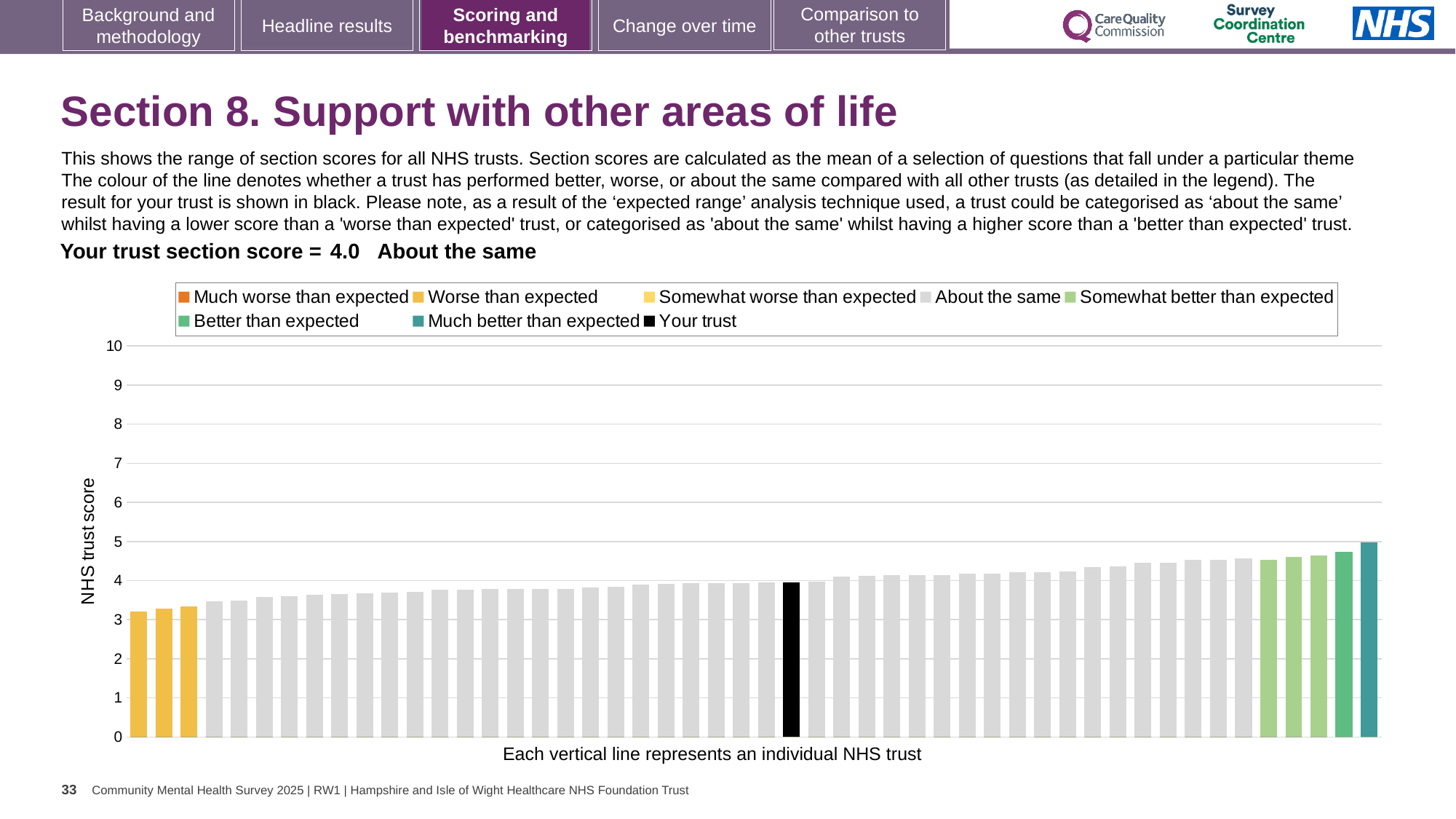
What is the label on the vertical axis? NHS trust score Is the value for the highest bar greater or less than 4? greater What colour is the bar for your trust? Black Which legend category does the highest bar belong to? Much better than expected Is the value for the lowest bar greater or less than 3? greater What is the section score for your trust? 4.0 What kind of chart is shown on the slide? Bar chart Do the bar values rise or fall from left to right along the x axis? Rise Which legend category does the lowest bar belong to? Worse than expected How many entries does the chart legend list? 8 Is the value for your trust greater or less than 5? less